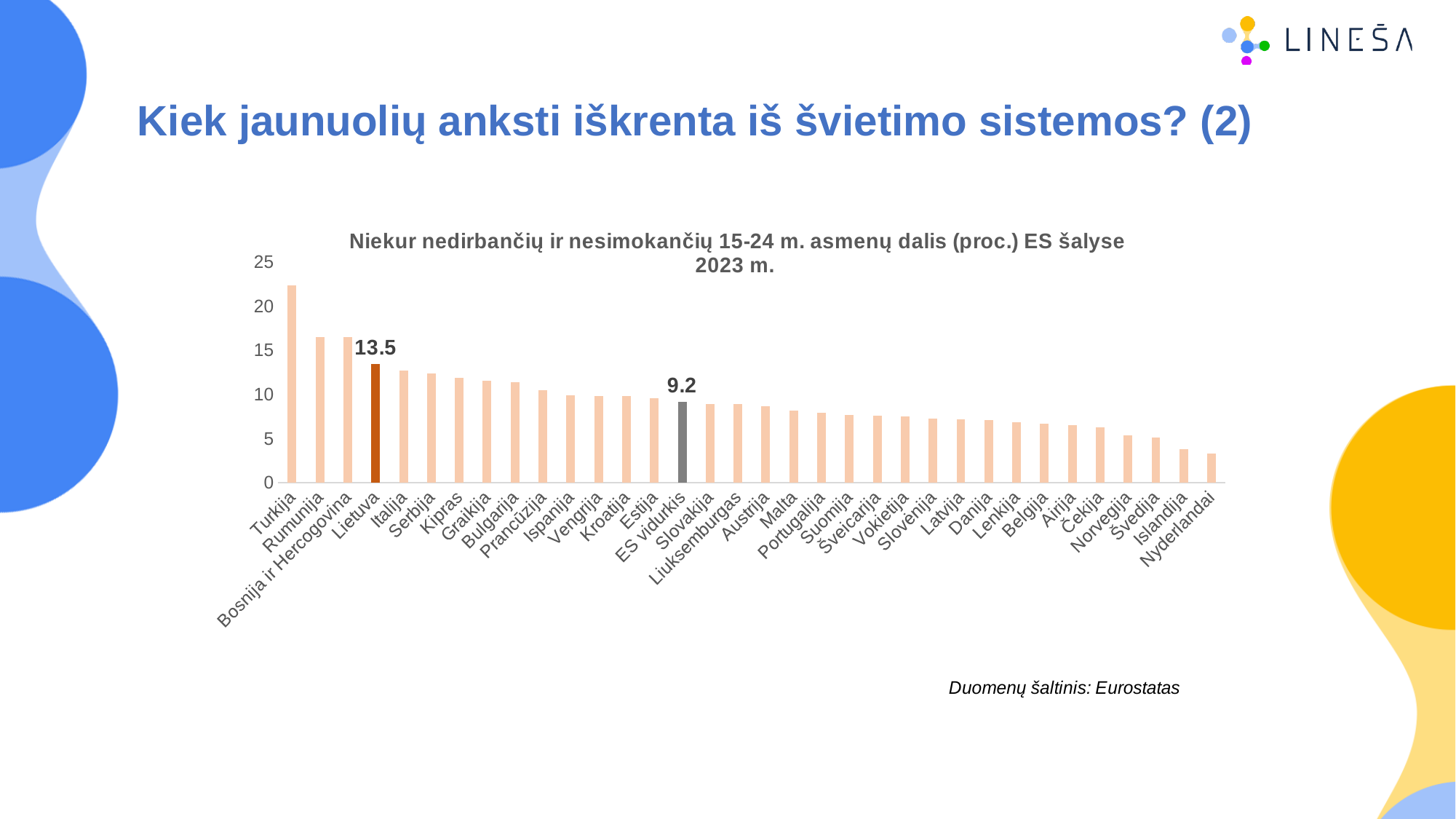
Do the values rise or fall from left to right along the x axis? fall Is the value for Rumunija greater or less than 15? greater Is the value for Nyderlandai greater or less than 5? less How many bars are shown in the chart? 34 Is the value for Turkija greater or less than 20? greater Which country has the lowest value? Nyderlandai What is the value for Lietuva? 13.5 Which is larger, the value for Lietuva or the value for ES vidurkis? Lietuva Which country has the highest value? Turkija What is the difference between the values for Lietuva and ES vidurkis? 4.3 What is the value for ES vidurkis? 9.2 What kind of chart is shown on the slide? bar chart